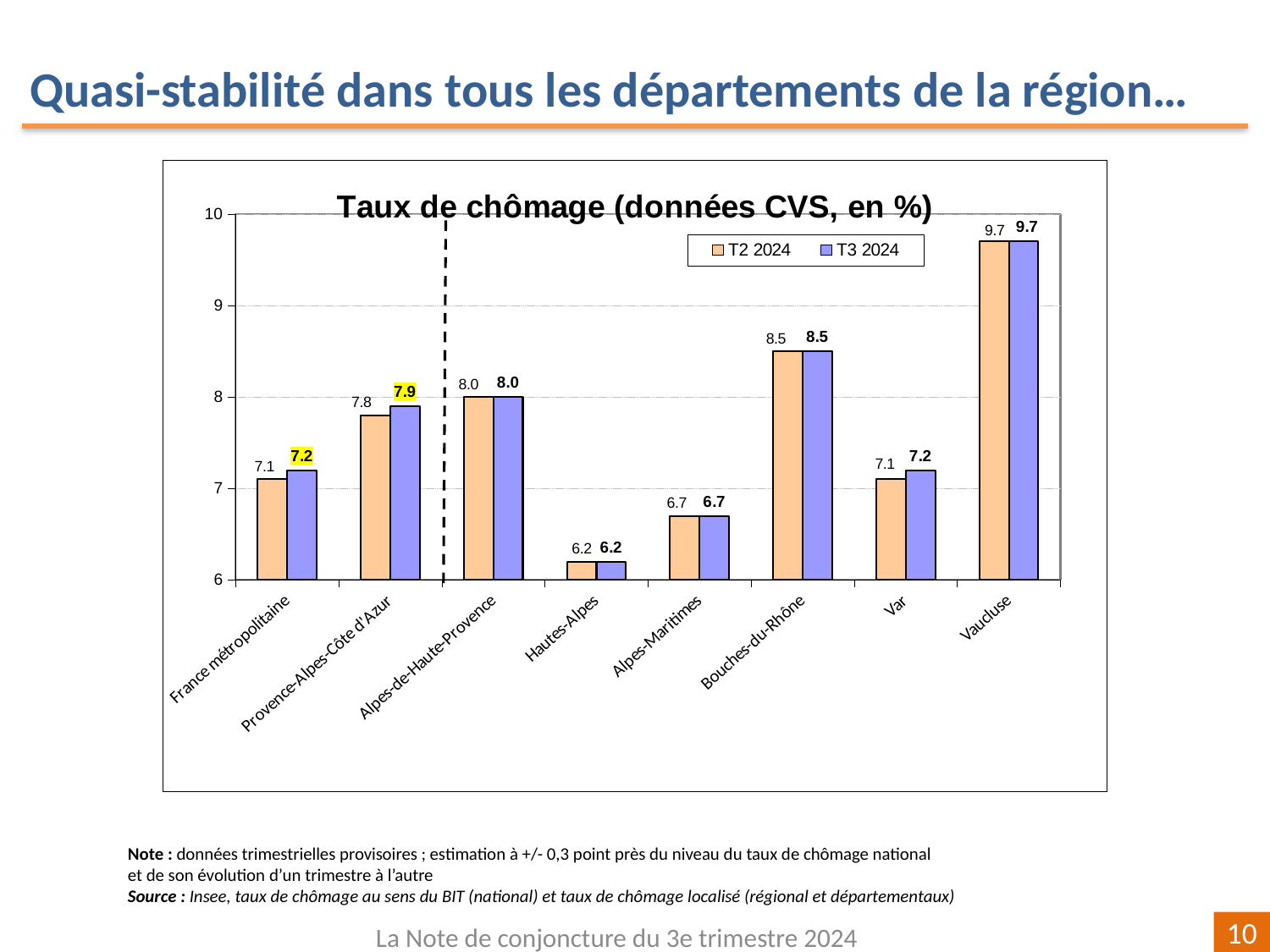
What is the difference between the T3 2024 and T2 2024 values for Provence-Alpes-Côte d'Azur? 0.1 Which category has the highest T3 2024 unemployment rate? Vaucluse Which is larger, the T3 2024 value for Var or for Alpes-de-Haute-Provence? Alpes-de-Haute-Provence What kind of chart is shown on the slide? Bar chart What is the T3 2024 unemployment rate for Vaucluse? 9.7 What is the T2 2024 unemployment rate for Provence-Alpes-Côte d'Azur? 7.8 What is the title of the chart? Taux de chômage (données CVS, en %) How many categories are shown on the x axis? 8 What is the T3 2024 value for Hautes-Alpes? 6.2 Which category has the lowest T2 2024 unemployment rate? Hautes-Alpes How many series does the legend list? 2 What is the difference between the T3 2024 values for Bouches-du-Rhône and Alpes-Maritimes? 1.8